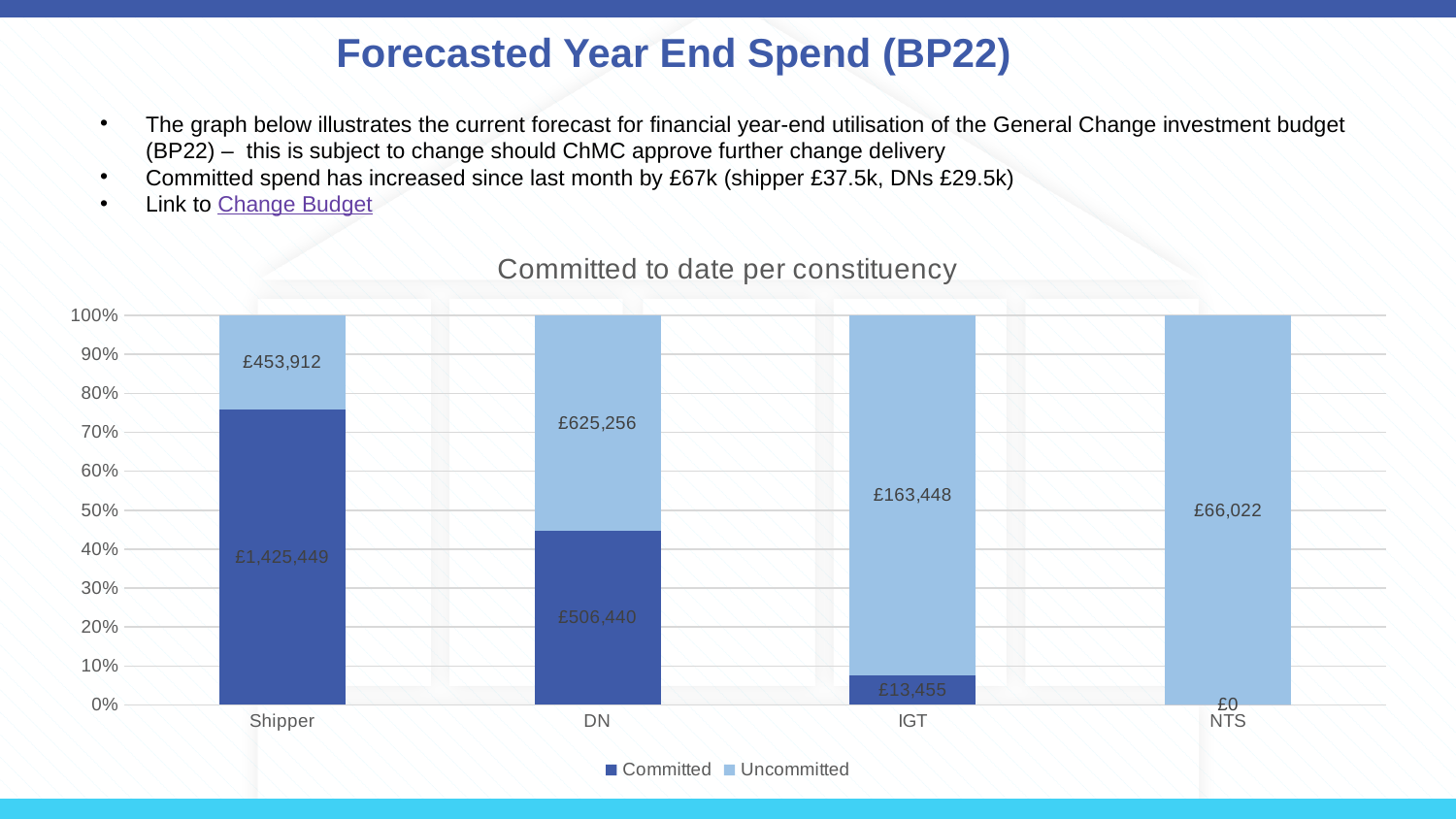
What is the Committed value for IGT? £13,455 What is the Committed value for NTS? £0 Which is larger for DN, the Committed value or the Uncommitted value? Uncommitted What is the total of the Committed and Uncommitted values for IGT? £176,903 Is the Committed share of the Shipper bar greater or less than 70%? greater What is the Committed value for Shipper? £1,425,449 How many series does the legend list? 2 Which constituency has the highest Committed value? Shipper Which constituency has the lowest Uncommitted value? NTS How many constituencies are shown on the x axis? 4 What is the Uncommitted value for DN? £625,256 What is the difference between the Uncommitted values for DN and Shipper? £171,344